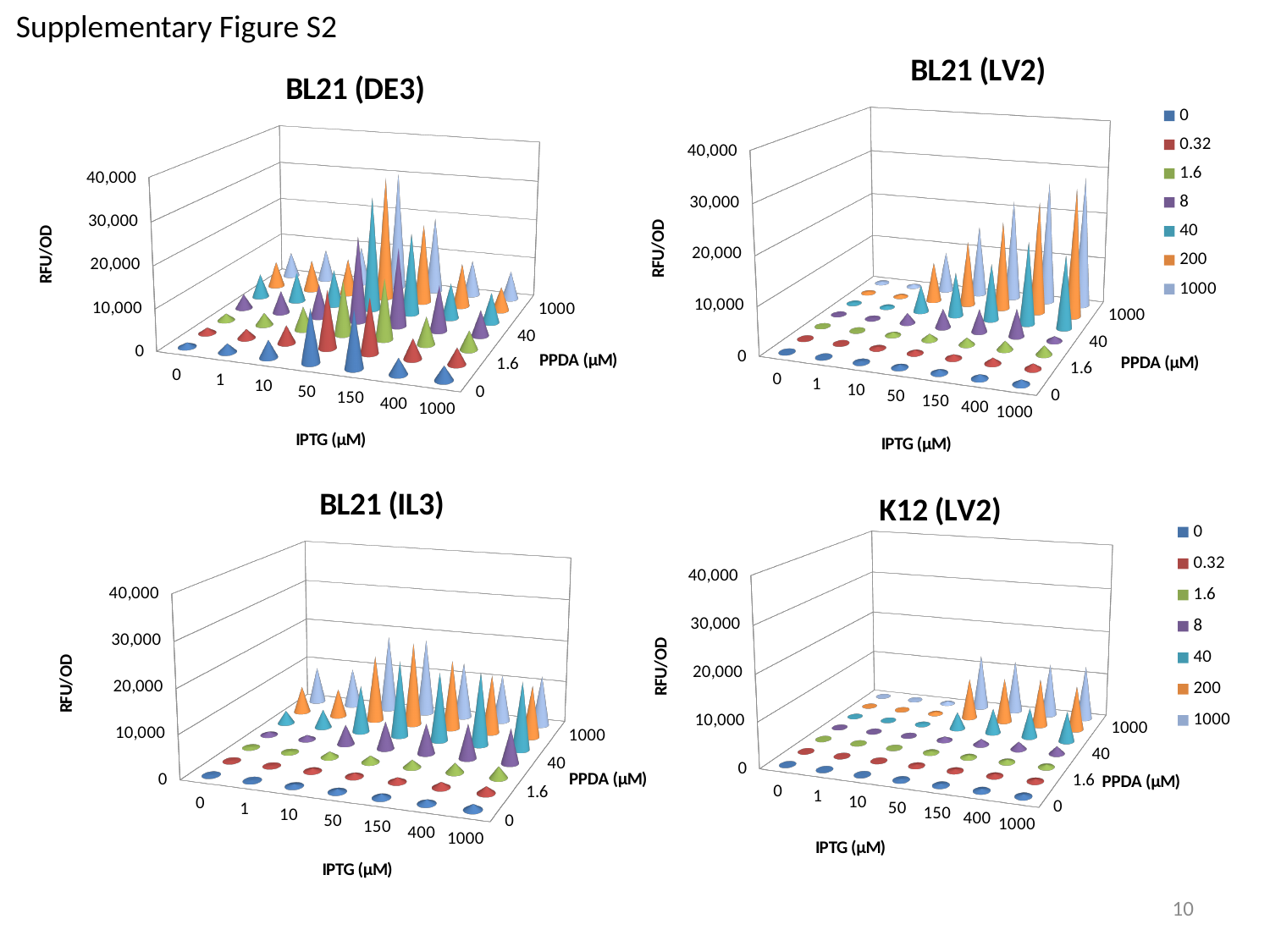
Which of the four charts shows the tallest cones? BL21 (DE3) How many series does the legend next to the BL21 (LV2) chart list? 7 In the BL21 (LV2) chart, is the value for IPTG 0 in the 0 series greater or less than 10,000? less In the BL21 (LV2) chart, do the values for the 1000 series rise or fall as IPTG increases from 0 to 1000? rise In the K12 (LV2) chart, is the value for IPTG 1000 in the 0 series greater or less than 10,000? less What is the label of the depth axis on the BL21 (DE3) chart? PPDA (μM) In the BL21 (DE3) chart, is the value for IPTG 0 in the 0 series greater or less than 10,000? less What is the label of the vertical axis on the K12 (LV2) chart? RFU/OD What kind of chart is the BL21 (DE3) chart? 3D bar chart How many IPTG concentration categories are shown along the x axis of the BL21 (IL3) chart? 7 What is the highest tick value shown on the RFU/OD axis of the BL21 (IL3) chart? 40,000